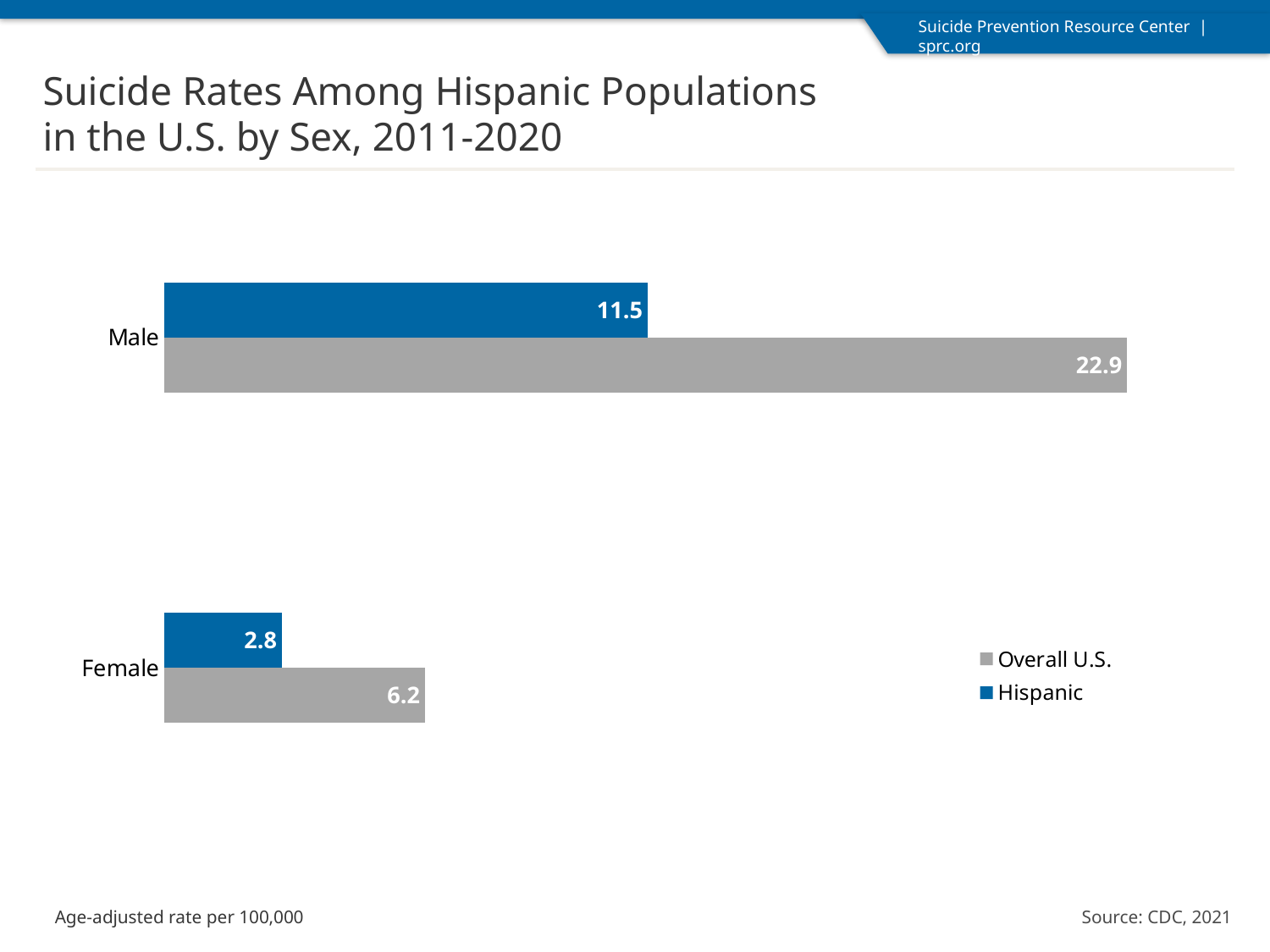
Which colour represents the Hispanic series in the legend? Blue What is the Overall U.S. suicide rate for males? 22.9 Which bar has the highest value on the chart? Overall U.S. Male What is the suicide rate for Hispanic males? 11.5 What is the suicide rate for Hispanic females? 2.8 What is the difference between the Overall U.S. and Hispanic rates for males? 11.4 Which is larger, the Hispanic male rate or the Overall U.S. female rate? Hispanic male rate What kind of chart is shown on the slide? Bar chart How many series does the legend list? 2 What is the Overall U.S. suicide rate for females? 6.2 Which bar has the lowest value on the chart? Hispanic Female What is the difference between the Overall U.S. and Hispanic rates for females? 3.4